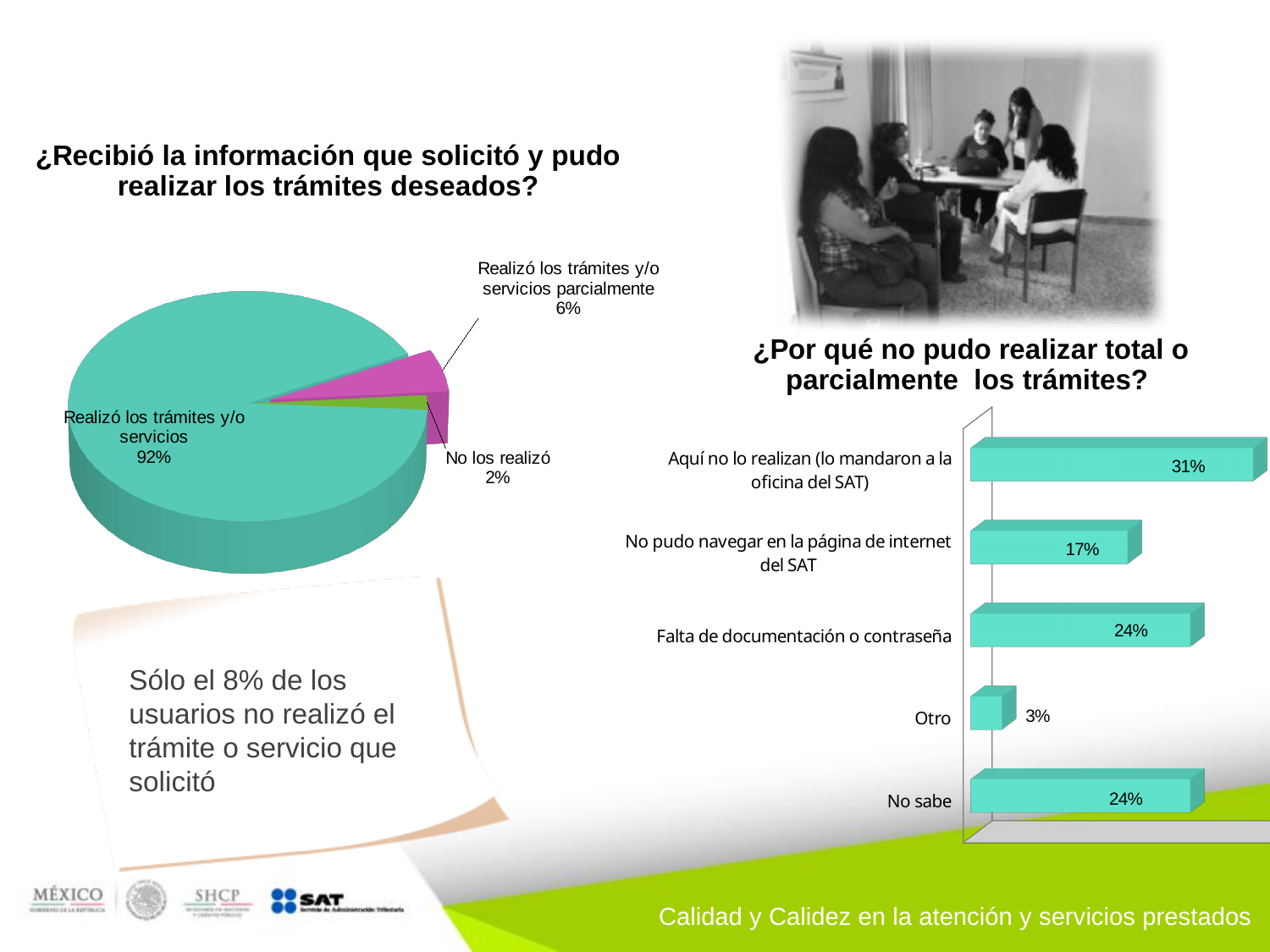
In the bar chart on the right, how many categories are shown? 5 In the bar chart on the right, what is the difference between 'Falta de documentación o contraseña' and 'Otro'? 21% In the pie chart on the left, what share of respondents answered 'Realizó los trámites y/o servicios parcialmente'? 6% What kind of chart is shown on the left of the slide? Pie chart In the bar chart on the right, which category has the lowest value? Otro In the bar chart on the right, what is the value for 'No pudo navegar en la página de internet del SAT'? 17% In the bar chart on the right, which category has the highest value? Aquí no lo realizan (lo mandaron a la oficina del SAT) In the pie chart on the left, what share of respondents answered 'Realizó los trámites y/o servicios'? 92% In the pie chart on the left, how many slices are there? 3 In the bar chart on the right, what is the value for 'Aquí no lo realizan (lo mandaron a la oficina del SAT)'? 31% In the pie chart on the left, which category has the smallest share? No los realizó In the pie chart on the left, what share of respondents answered 'No los realizó'? 2%